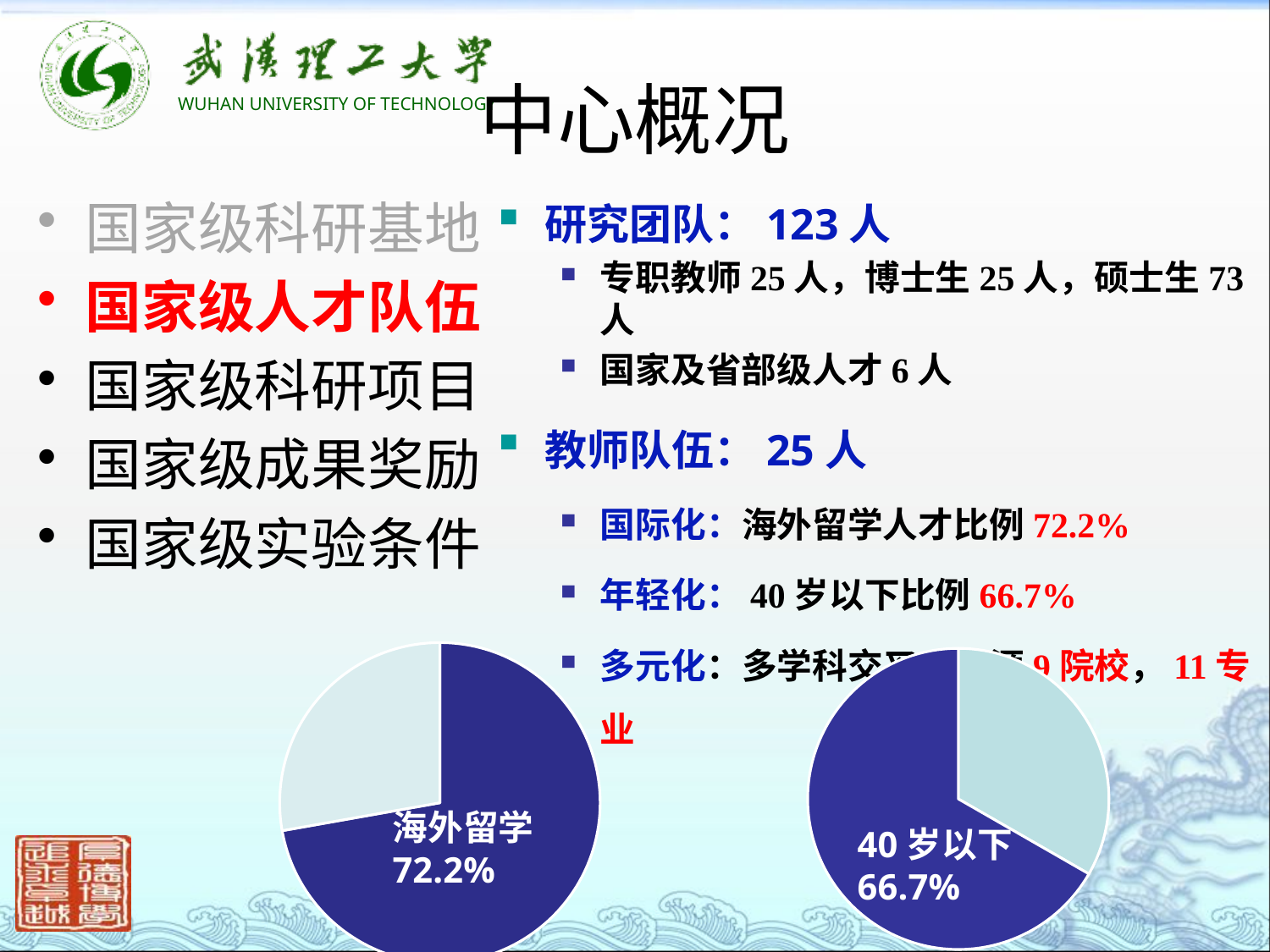
In the right pie chart, which slice is larger: the 40岁以下 slice or the unlabelled slice? 40岁以下 Which labelled share is larger: 海外留学 in the left pie chart or 40岁以下 in the right pie chart? 海外留学 How many slices does the right pie chart have? 2 In the left pie chart, which slice is larger: the 海外留学 slice or the unlabelled slice? 海外留学 What kind of chart is the left chart on the slide? pie chart In the left pie chart, what colour is the 海外留学 slice? dark blue In the right pie chart, what share is labelled for 40岁以下? 66.7% What kind of chart is the right chart on the slide? pie chart What is the difference between the 海外留学 share in the left pie chart and the 40岁以下 share in the right pie chart? 5.5% In the left pie chart, what share is labelled for 海外留学? 72.2% How many slices does the left pie chart have? 2 In the right pie chart, what colour is the unlabelled slice? light blue